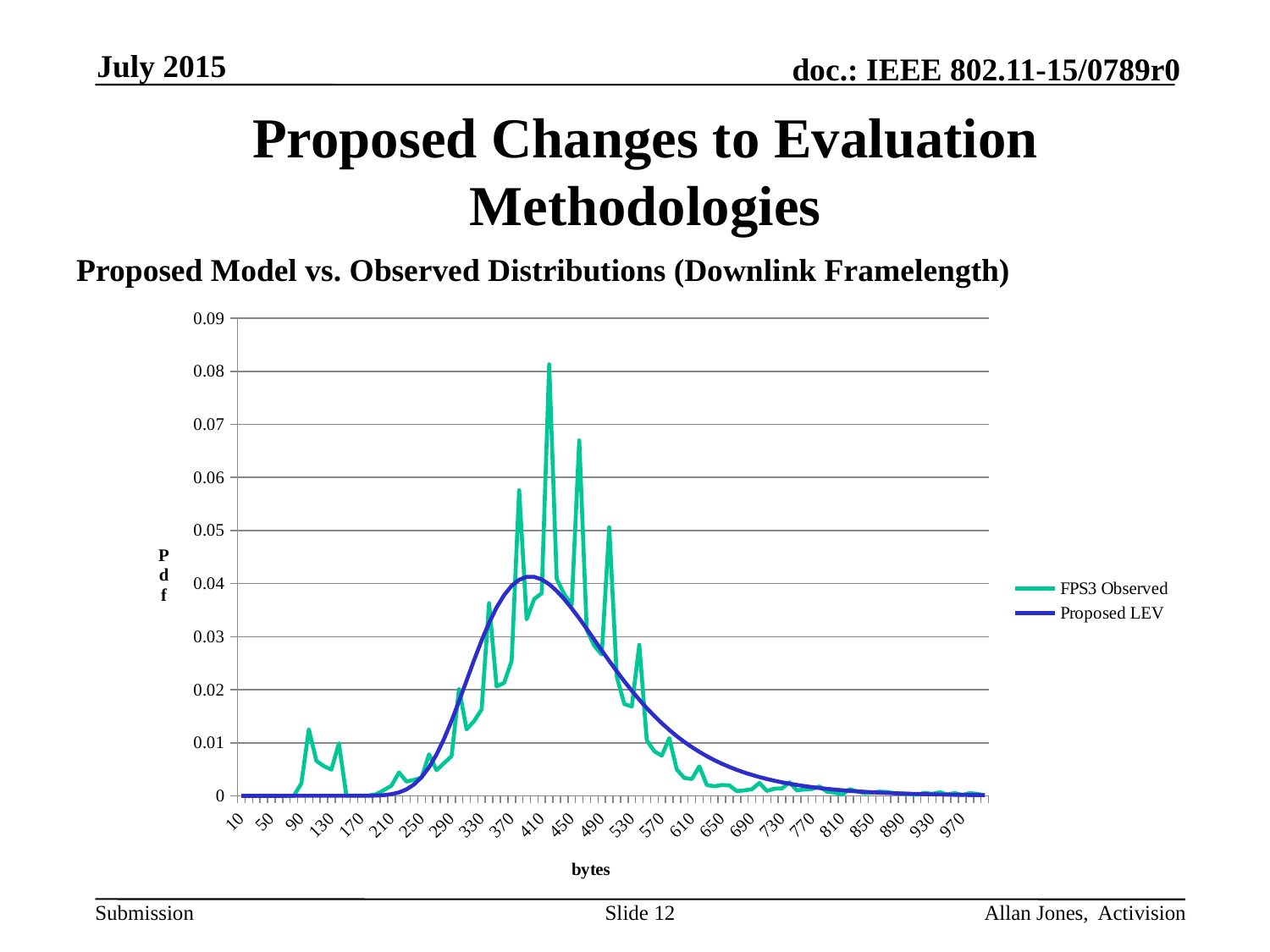
What kind of chart is shown on the slide? line chart Is the highest value of the Proposed LEV series greater or less than 0.05? less Is the value of Proposed LEV at 610 bytes greater or less than 0.02? less What are the two series named in the legend? FPS3 Observed and Proposed LEV Is the value of Proposed LEV at 970 bytes greater or less than 0.01? less Which series reaches the higher peak value? FPS3 Observed Does the Proposed LEV curve rise or fall between 450 and 970 bytes? fall Does the Proposed LEV curve rise or fall between 210 and 370 bytes? rise How many series does the legend list? 2 What is the title of the chart? Proposed Model vs. Observed Distributions (Downlink Framelength)